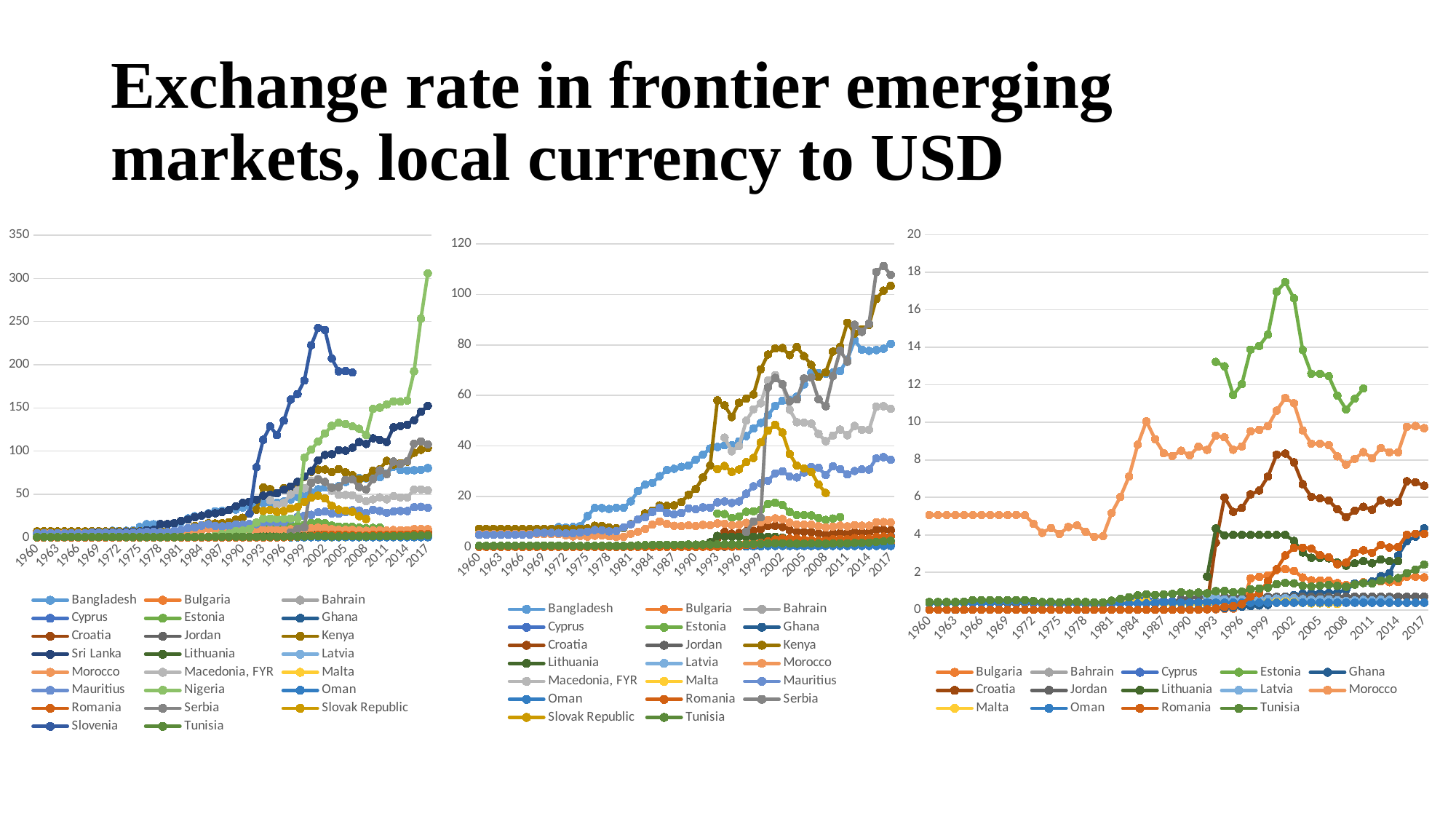
In the right chart, which series reaches the highest value? Estonia How many series does the legend of the right chart list? 14 In the right chart, does the value for Estonia rise or fall between 2001 and 2009? fall What kind of chart is the left chart on the slide? line chart In the left chart, is the value for Nigeria in 2017 greater or less than 250? greater In the right chart, which is larger in 2017, Morocco or Croatia? Morocco How many series does the legend of the left chart list? 23 In the right chart, is the peak value for Estonia around 2001 greater or less than 16? greater In the left chart, is the peak value for Slovenia around 2001 greater or less than 200? greater What is the title of the slide? Exchange rate in frontier emerging markets, local currency to USD How many series does the legend of the middle chart list? 20